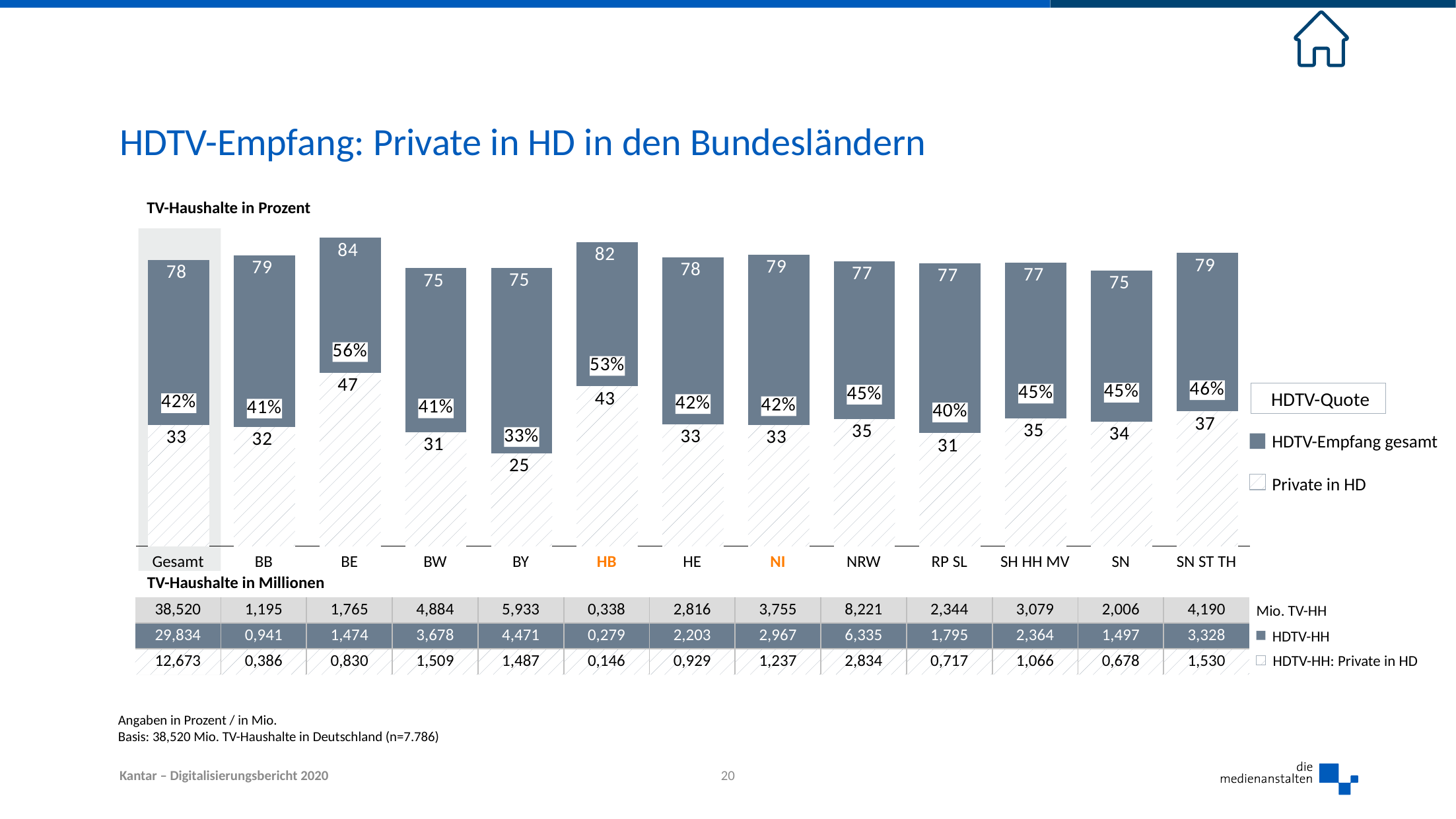
Which is larger, the Private in HD value for BE or for SN ST TH? BE Which Bundesland has the highest HDTV-Empfang gesamt value? BE What is the difference between the HDTV-Empfang gesamt value and the Private in HD value for Gesamt? 45 How many series does the legend list for the bars? 2 What is the HDTV-Quote shown for RP SL? 40% What is the HDTV-HH value in millions for NRW in the table below the chart? 6,335 What is the HDTV-Empfang gesamt value for BE? 84 What is the HDTV-Quote shown for HB? 53% What kind of chart is shown on the slide? bar chart How many categories are shown on the x axis of the chart? 13 What is the Private in HD value for BY? 25 Which category has the lowest Private in HD value? BY